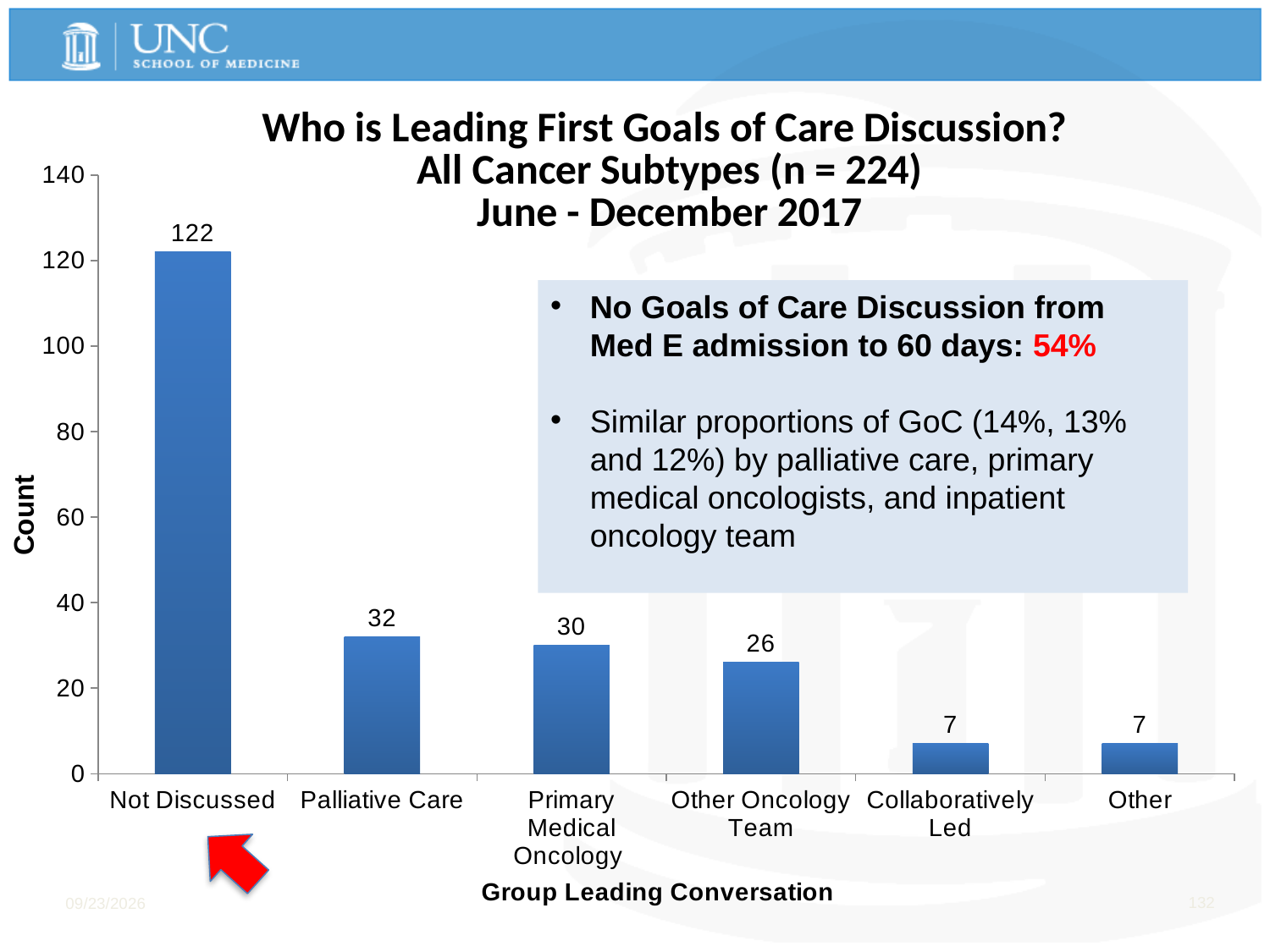
How many groups are shown on the x axis? 6 What is the label of the y axis? Count What is the count for Other Oncology Team? 26 What is the difference between the counts for Primary Medical Oncology and Other Oncology Team? 4 Is the count for Not Discussed greater or less than 100? greater What is the difference between the counts for Not Discussed and Palliative Care? 90 Which group has the highest count? Not Discussed What is the count for Palliative Care? 32 Which is larger, the count for Palliative Care or the count for Primary Medical Oncology? Palliative Care What is the count for Not Discussed? 122 What is the label of the x axis? Group Leading Conversation What kind of chart is shown on the slide? Bar chart